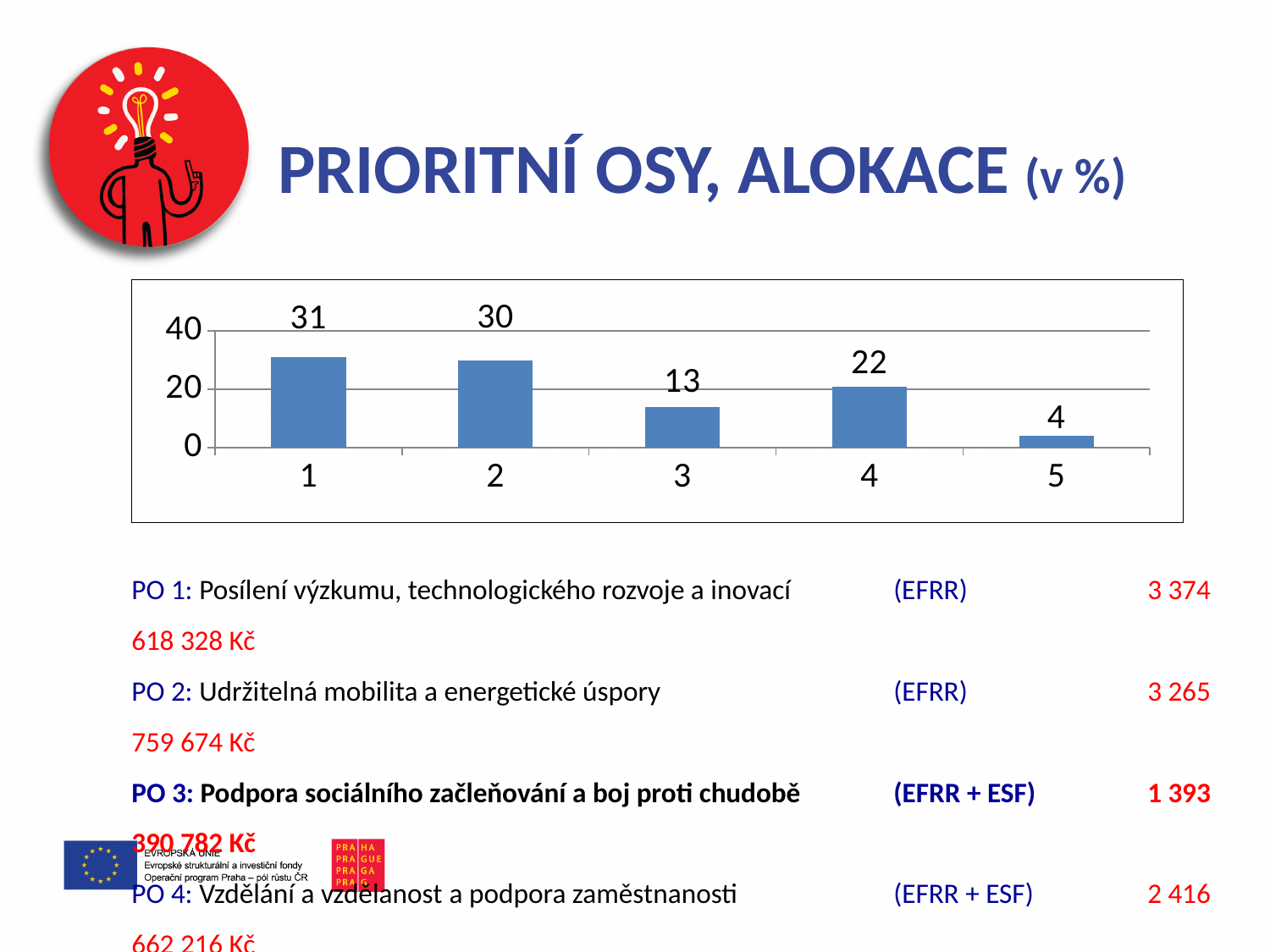
What is the value for category 1? 31 What is the difference between the values for category 1 and category 3? 18 What is the total of the values for categories 1 and 2? 61 How many categories are shown on the x axis? 5 What is the difference between the values for category 4 and category 5? 18 What kind of chart is shown on the slide? bar chart Is the value for category 2 greater or less than 20? greater What is the value for category 5? 4 Which category has the highest value? 1 Which category has the lowest value? 5 What is the value for category 3? 13 Which is larger, the value for category 3 or the value for category 4? category 4